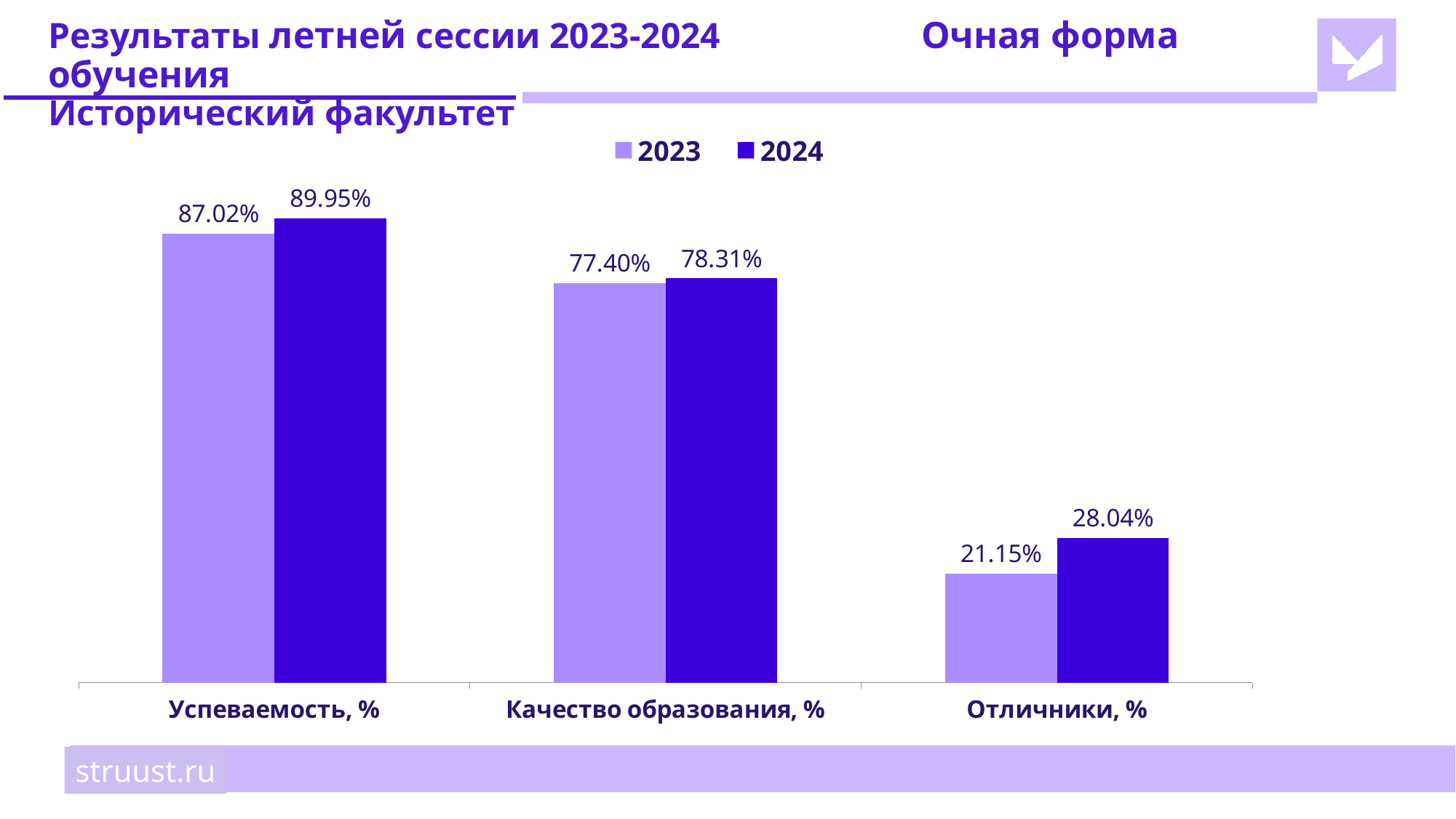
How many series does the legend list? 2 What is the 2024 value for Качество образования, %? 78.31% For Отличники, %, which year has the larger value, 2023 or 2024? 2024 What is the 2023 value for Успеваемость, %? 87.02% Which category has the highest 2024 value? Успеваемость, % What is the 2024 value for Отличники, %? 28.04% What kind of chart is shown on the slide? Bar chart What is the difference between the 2024 and 2023 values for Отличники, %? 6.89% How many categories are shown on the x axis? 3 What is the difference between the 2024 and 2023 values for Успеваемость, %? 2.93% Which category has the lowest 2023 value? Отличники, % What is the 2023 value for Отличники, %? 21.15%